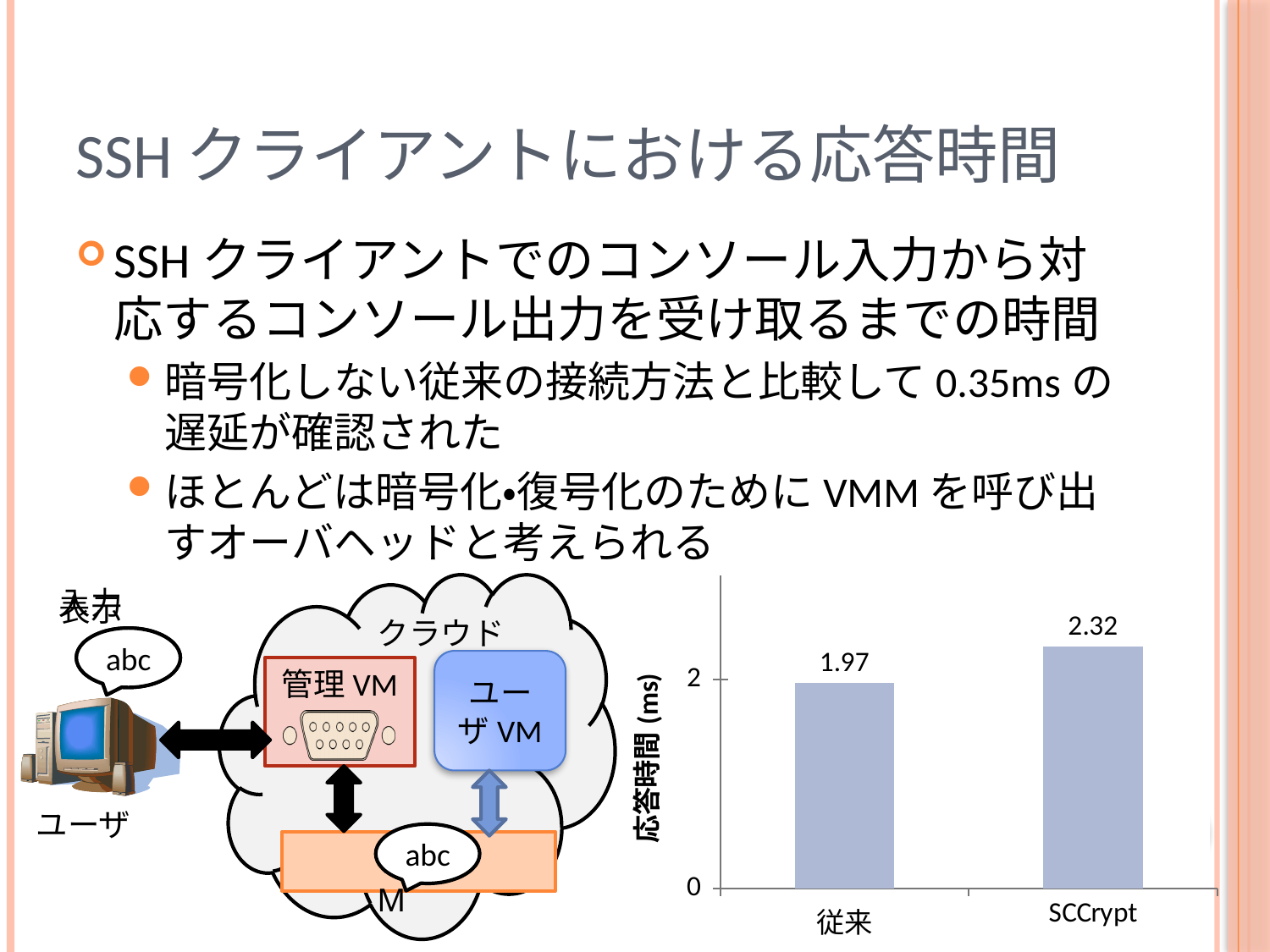
Is the value for SCCrypt greater or less than 2? greater Is the response time for SCCrypt larger or smaller than that for 従来? larger Is the value for 従来 greater or less than 2? less What is the label of the y axis of the bar chart? 応答時間 (ms) What is the response time value for 従来 in the bar chart? 1.97 What is the response time value for SCCrypt in the bar chart? 2.32 Which category has the lower response time in the bar chart? 従来 What kind of chart is shown on the slide? bar chart How many categories are shown in the bar chart? 2 What is the maximum tick value shown on the y axis of the bar chart? 2 What is the difference between the response times of SCCrypt and 従来? 0.35 Which category has the higher response time in the bar chart? SCCrypt